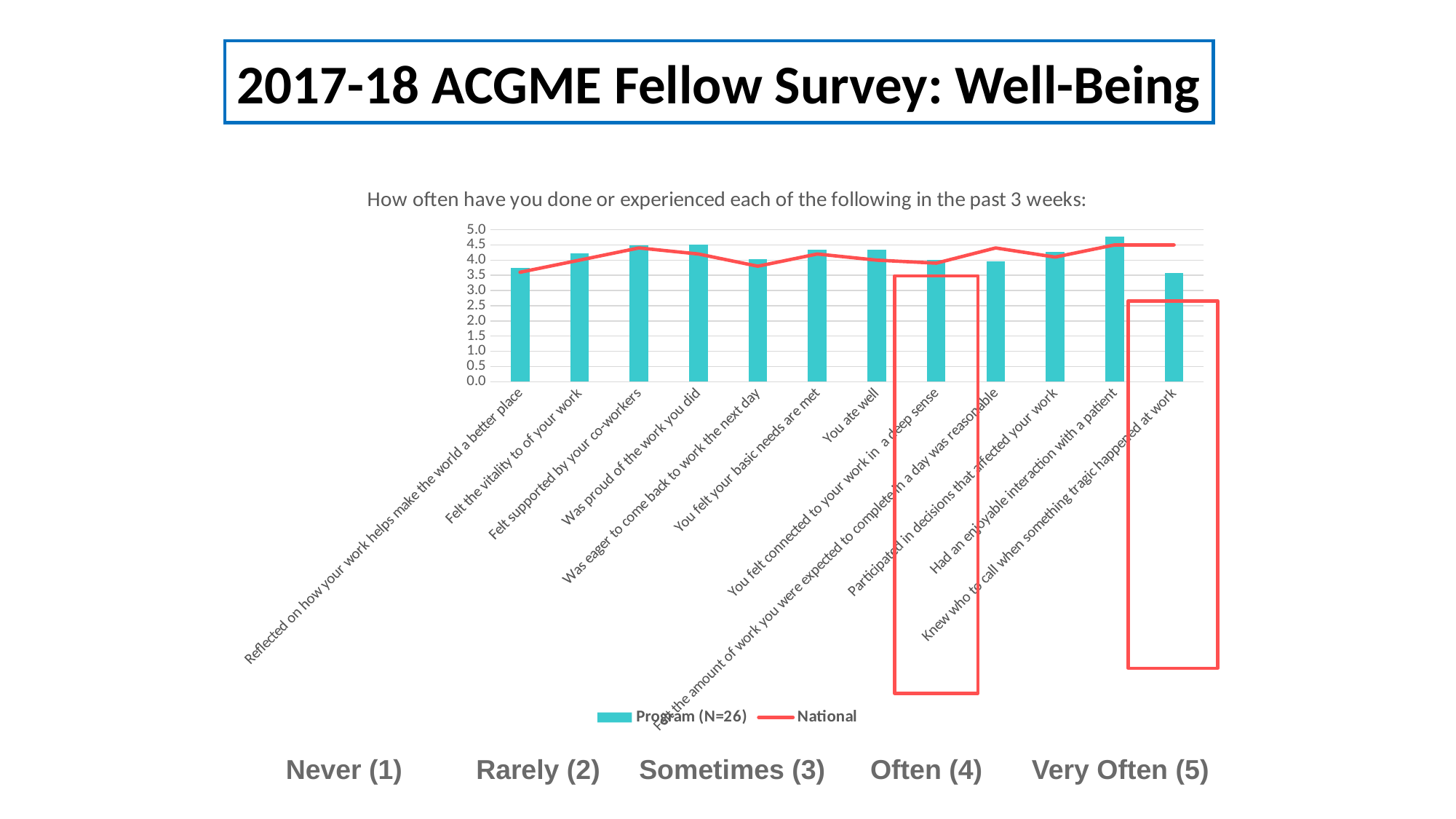
Is the Program (N=26) value for 'Reflected on how your work helps make the world a better place' greater or less than 4.0? less Which category has the highest Program (N=26) bar? Had an enjoyable interaction with a patient What is the maximum value shown on the chart's vertical axis? 5.0 What are the two series named in the chart legend? Program (N=26) and National What kind of chart is used for the Program (N=26) series? Bar chart Is the Program (N=26) value for 'Knew who to call when something tragic happened at work' greater or less than 4.0? less How many series does the chart legend list? 2 Is the Program (N=26) value for 'Was proud of the work you did' greater or less than 4.0? greater Which has the larger Program (N=26) value: 'Had an enjoyable interaction with a patient' or 'Knew who to call when something tragic happened at work'? Had an enjoyable interaction with a patient Which has the larger Program (N=26) value: 'Was proud of the work you did' or 'Reflected on how your work helps make the world a better place'? Was proud of the work you did How many categories are shown on the x axis of the chart? 12